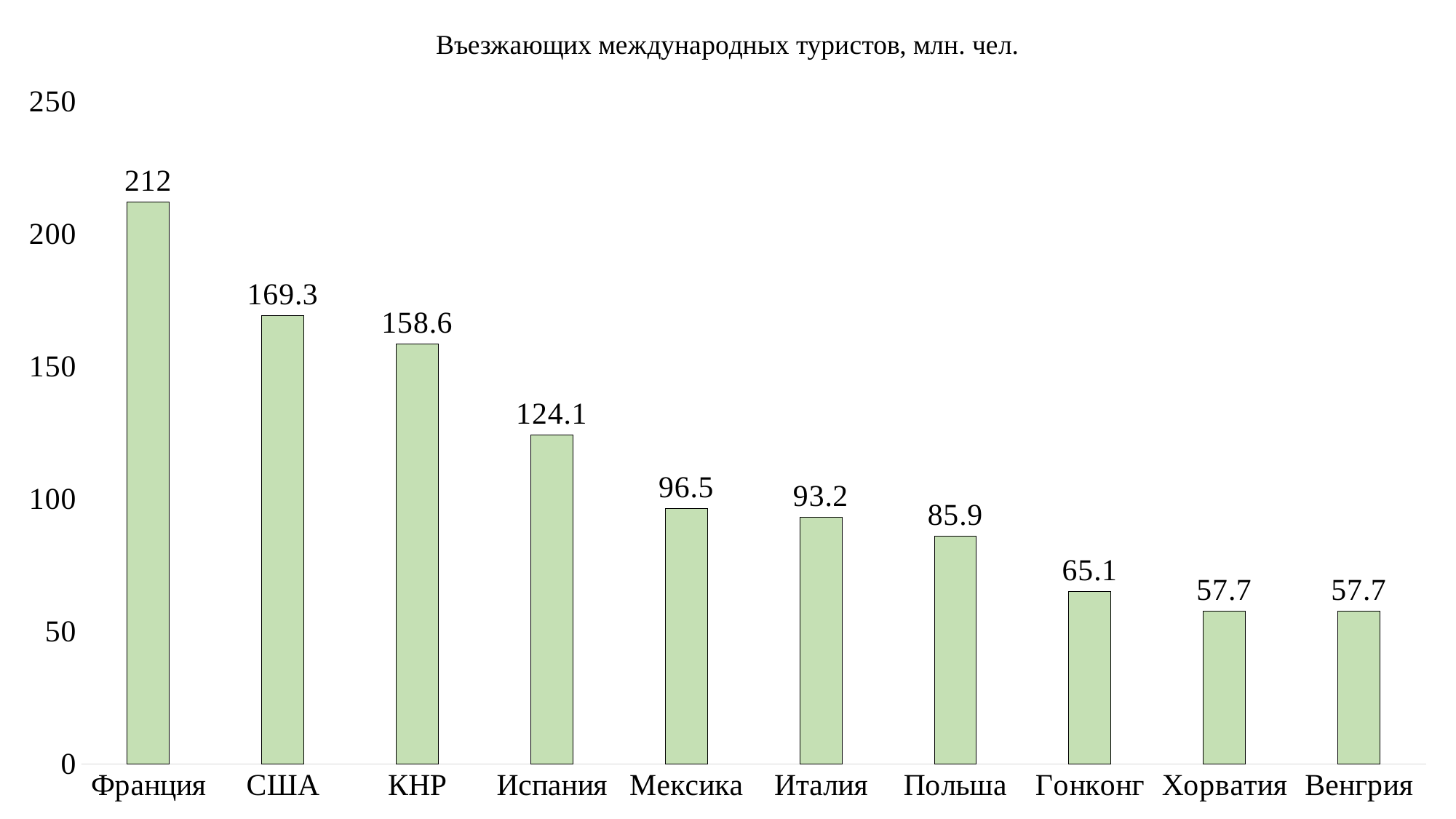
What is the difference between the values for Франция and Испания? 87.9 How many countries are shown on the chart? 10 What kind of chart is this? bar chart Is the value for КНР greater or less than 150? greater What is the value for Франция? 212 What is the difference between the values for США and КНР? 10.7 Which country has the highest value? Франция Which is larger, the value for Мексика or the value for Гонконг? Мексика Do the values rise or fall from left to right along the x axis? fall What is the title of the chart? Въезжающих международных туристов, млн. чел. What is the value for Польша? 85.9 What is the value for Испания? 124.1